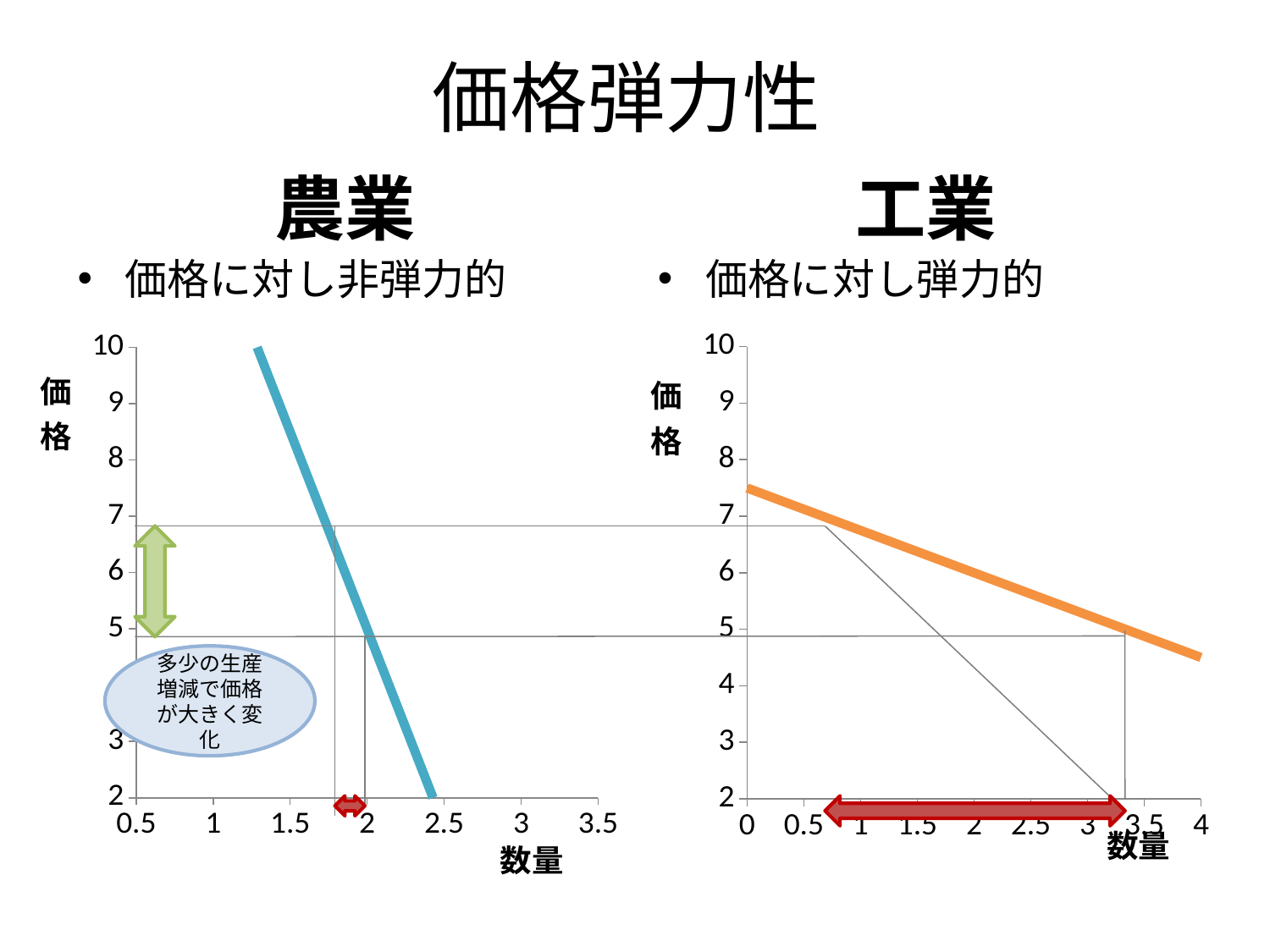
In the 工業 chart on the right, is the value of the line at 数量 = 4 greater or less than 5? less In the 工業 chart on the right, is the value of the line at 数量 = 0 greater or less than 7? greater What kind of chart is the 農業 chart on the left? line chart In the 工業 chart on the right, is the value of the line at 数量 = 2 greater or less than 5? greater In the 農業 chart on the left, does the plotted line rise or fall as 数量 increases? fall What colour is the plotted line in the 工業 chart on the right? orange In the 工業 chart on the right, does the plotted line rise or fall as 数量 increases? fall What kind of chart is the 工業 chart on the right? line chart What is the label of the vertical axis on the 農業 chart on the left? 価格